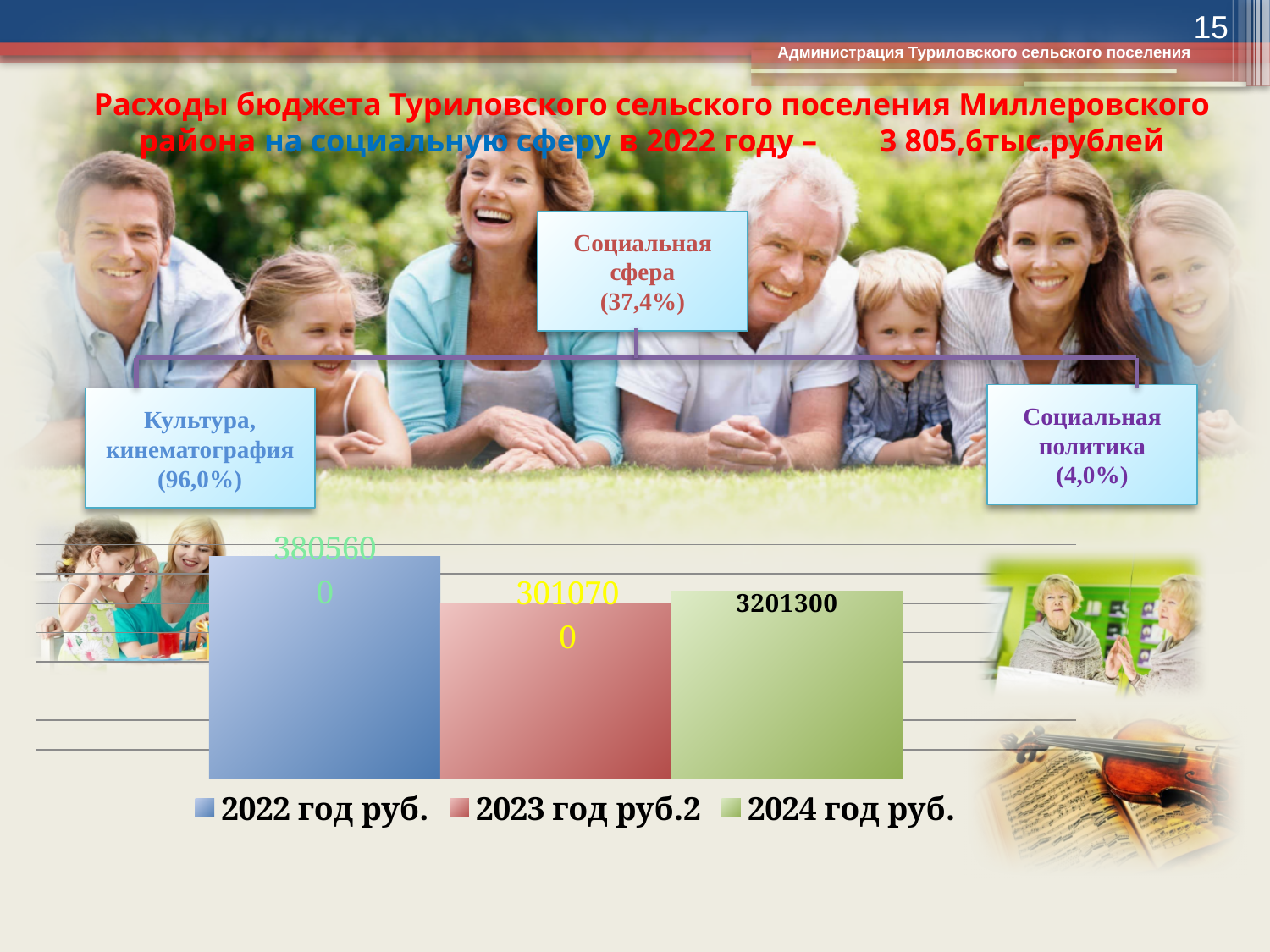
Which is larger, the 2023 год руб.2 value or the 2024 год руб. value? 2024 год руб. What is the value shown for the 2024 год руб. bar? 3201300 Which series has the highest value in the chart? 2022 год руб. What is the difference between the 2024 год руб. value and the 2023 год руб.2 value? 190600 What is the value shown for the 2023 год руб.2 bar? 3010700 Which series has the lowest value in the chart? 2023 год руб.2 What is the value shown for the 2022 год руб. bar? 3805600 What is the difference between the 2022 год руб. value and the 2024 год руб. value? 604300 What colour is the bar for 2022 год руб.? blue How many series does the chart legend list? 3 What kind of chart is shown on the slide? bar chart What is the difference between the 2022 год руб. value and the 2023 год руб.2 value? 794900